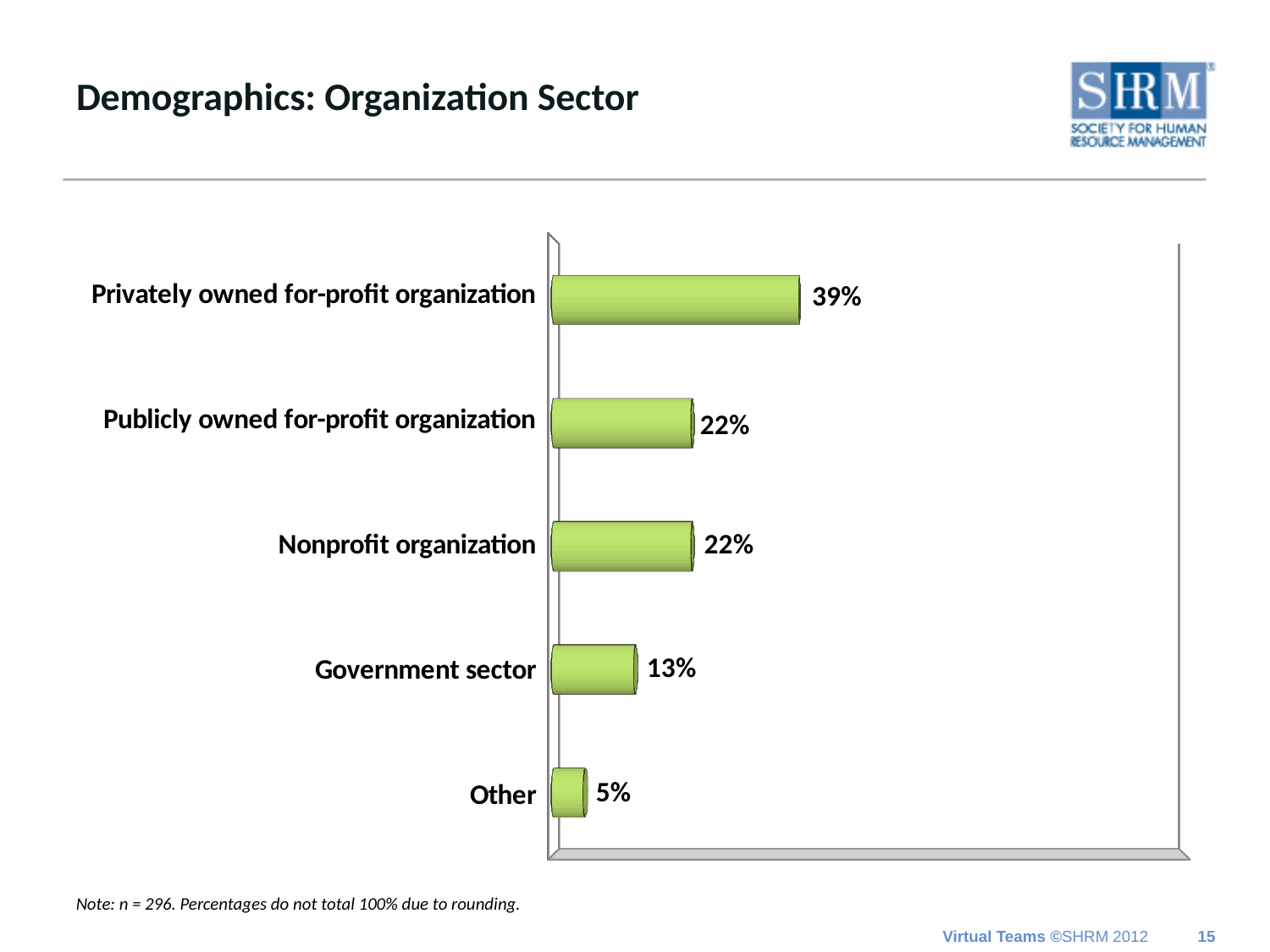
Which is larger, the value for Nonprofit organization or the value for Government sector? Nonprofit organization What is the value for Nonprofit organization? 22% What kind of chart is shown on the slide? Bar chart What is the value for Government sector? 13% What is the difference between the percentages for Government sector and Other? 8% Which category has the lowest percentage? Other How many organization sector categories are shown in the chart? 5 Which organization sector has the highest percentage? Privately owned for-profit organization What is the value for Other? 5% What is the title of the slide containing the chart? Demographics: Organization Sector What is the difference between the percentages for Privately owned for-profit organization and Publicly owned for-profit organization? 17% What percentage of respondents are from a privately owned for-profit organization? 39%